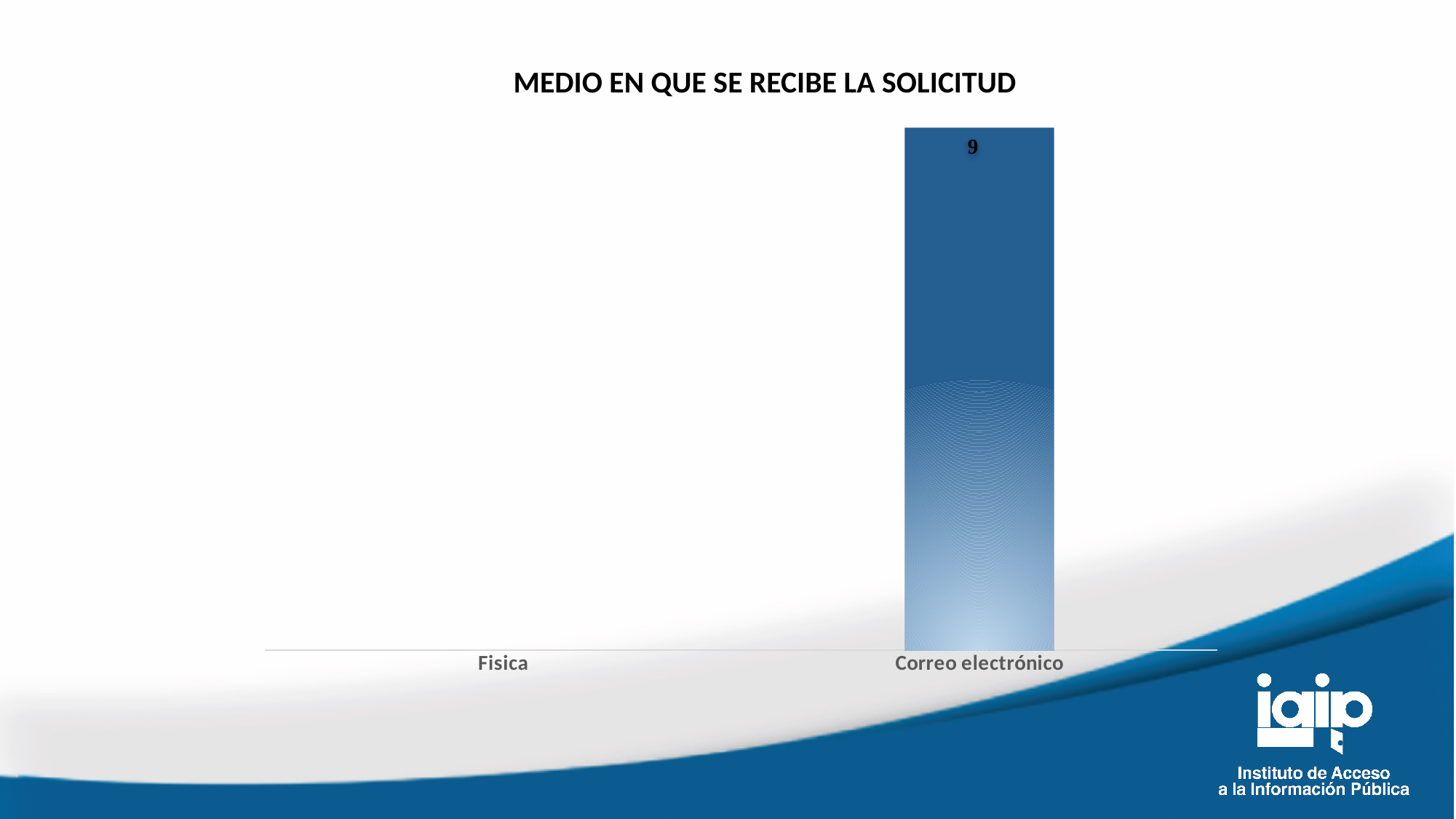
Which is larger, the value for Fisica or the value for Correo electrónico? Correo electrónico What is the title of the chart? MEDIO EN QUE SE RECIBE LA SOLICITUD What is the label of the first category on the x axis? Fisica Which category has the lowest value? Fisica Which category has the highest value? Correo electrónico What kind of chart is shown on the slide? Bar chart Do the values rise or fall from Fisica to Correo electrónico? Rise What is the value for Correo electrónico? 9 How many categories are shown on the x axis? 2